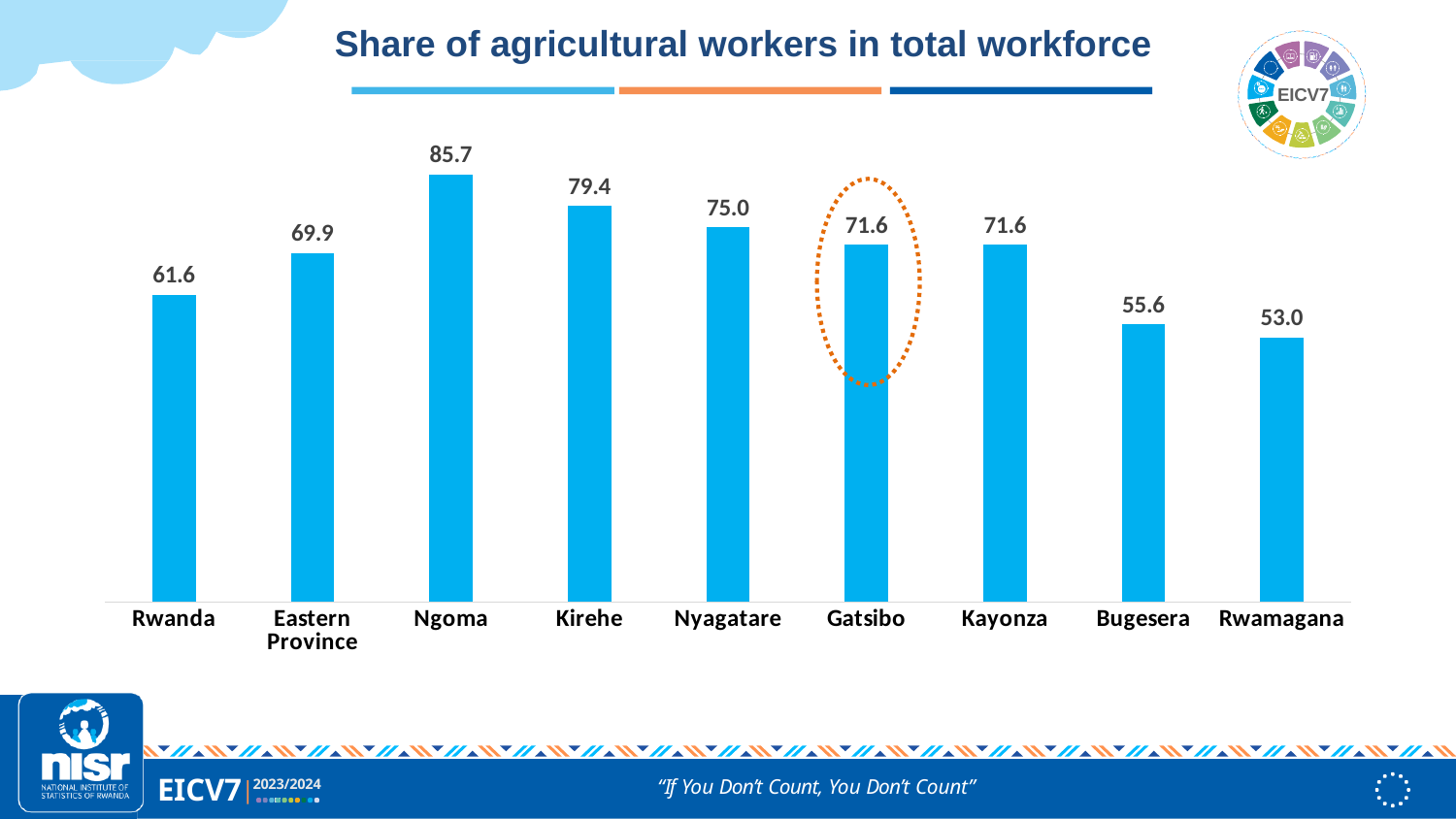
What is the difference between the values for Ngoma and Rwamagana? 32.7 What is the difference between the values for Kirehe and Bugesera? 23.8 What is the title of the chart? Share of agricultural workers in total workforce What value is shown for Rwanda? 61.6 Which category has the highest share of agricultural workers? Ngoma What kind of chart is shown on the slide? Bar chart Which category has the lowest share of agricultural workers? Rwamagana What is the share of agricultural workers in the total workforce for Ngoma? 85.7 Which has a larger value, Nyagatare or Kayonza? Nyagatare How many categories are shown on the x axis? 9 What value is shown for Gatsibo, the category highlighted with a dotted circle? 71.6 What is the value for Eastern Province? 69.9